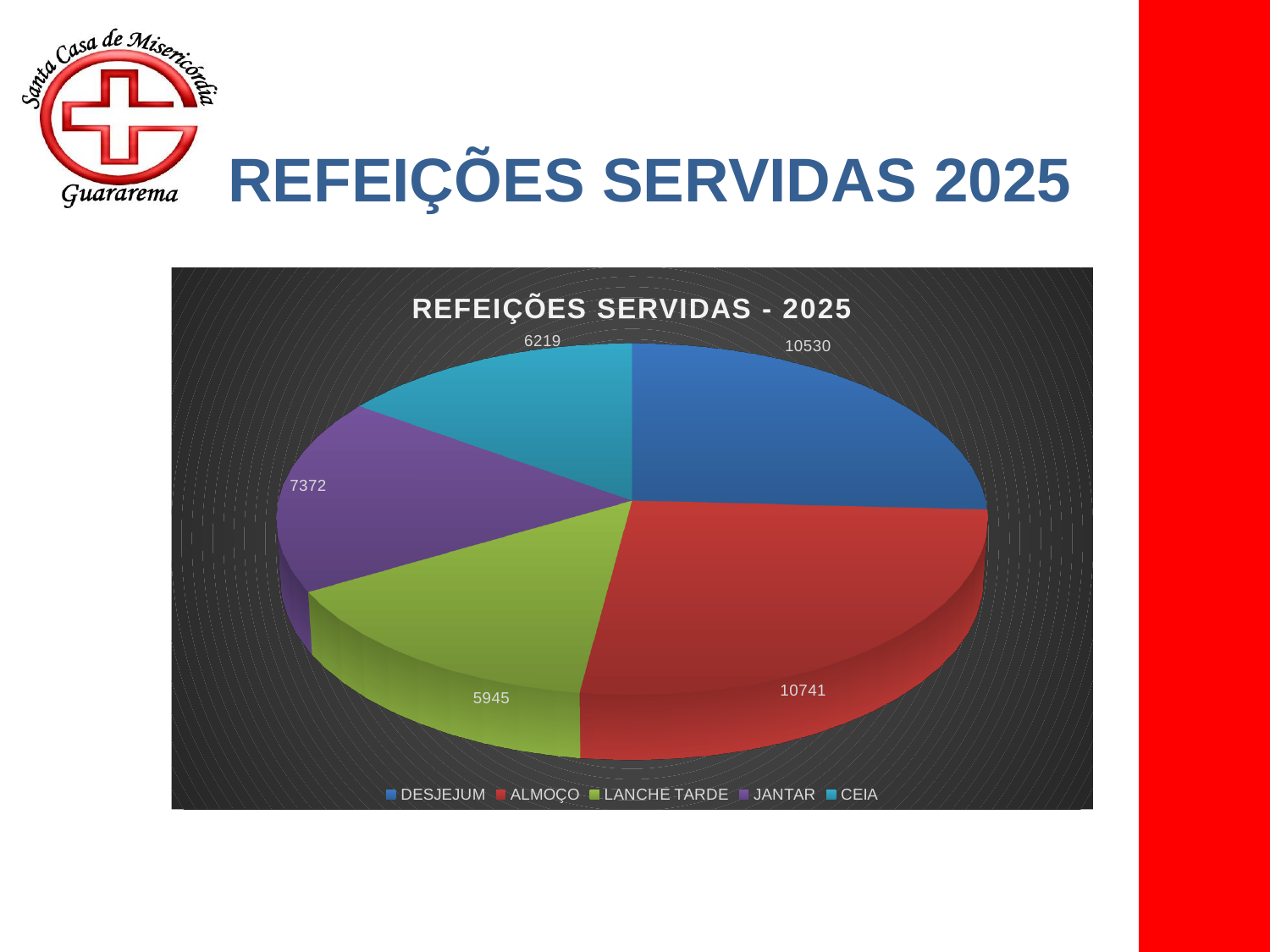
What is the difference between the values for ALMOÇO and DESJEJUM? 211 Which is larger, the value for JANTAR or the value for CEIA? JANTAR What is the value for ALMOÇO? 10741 What is the value for DESJEJUM? 10530 Which meal has the highest number of servings? ALMOÇO What is the value for CEIA? 6219 What is the value for LANCHE TARDE? 5945 How many meals (slices) does the pie chart show? 5 Which meal has the lowest number of servings? LANCHE TARDE What is the value for JANTAR? 7372 What kind of chart is shown on the slide? Pie chart What is the title of the chart? REFEIÇÕES SERVIDAS - 2025